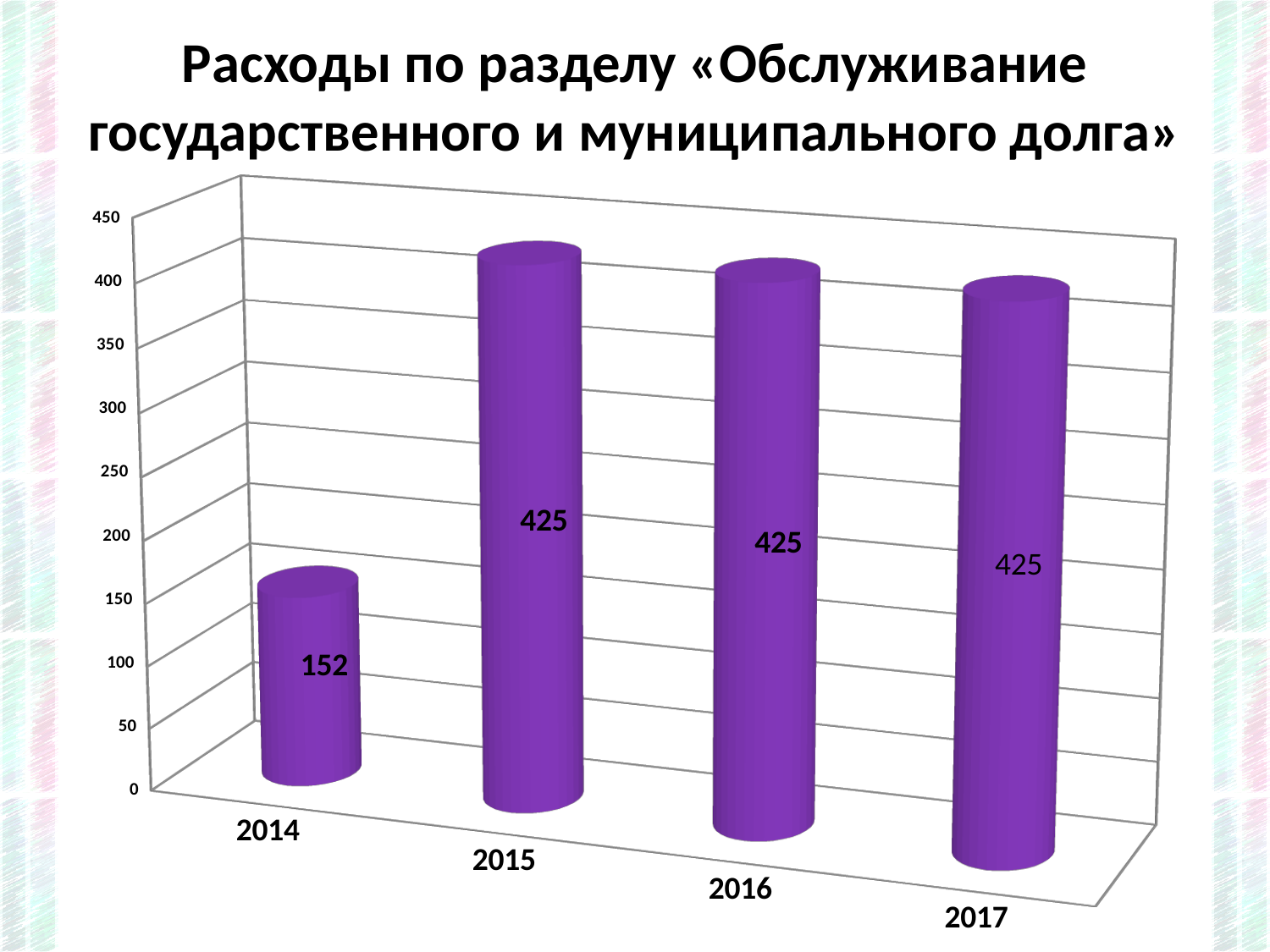
Is the value for 2016 greater or less than 400? greater What kind of chart is shown on the slide? bar chart Is the value for 2014 greater or less than 200? less How many years are shown on the x axis? 4 Which is larger, the value for 2014 or the value for 2016? 2016 What is the value for 2014? 152 What is the value for 2015? 425 Do the values rise or fall from 2014 to 2015? rise What is the highest value shown on the vertical axis? 450 Which year has the lowest value? 2014 What is the value for 2017? 425 What is the difference between the values for 2015 and 2014? 273